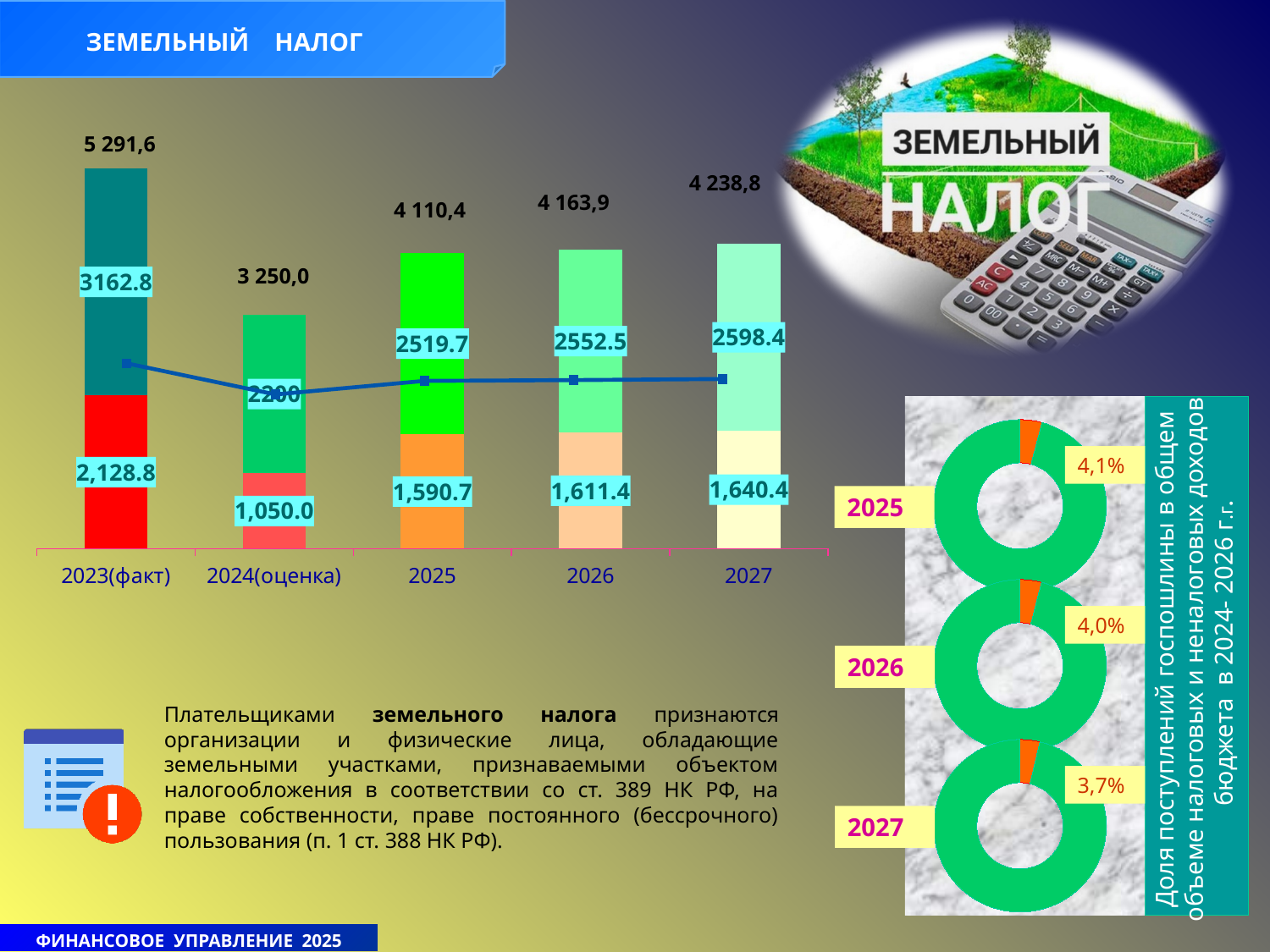
In the donut charts on the right, which year has the lowest percentage? 2027 In the stacked bar chart, what is the difference between the bottom segment values of the 2027 bar and the 2026 bar? 29.0 In the stacked bar chart, which category has the highest total value? 2023(факт) In the stacked bar chart, do the total values rise or fall from 2025 to 2027? rise In the stacked bar chart, which category has the lowest total value? 2024(оценка) In the donut charts on the right, what percentage is shown for 2025? 4,1% In the stacked bar chart, what is the value of the top segment of the 2027 bar? 2598.4 In the stacked bar chart, what is the total value labelled above the bar for 2023(факт)? 5 291,6 In the stacked bar chart, how many categories are shown on the x axis? 5 In the stacked bar chart, what is the value of the bottom segment of the 2025 bar? 1,590.7 In the stacked bar chart, is the bottom segment of the 2026 bar larger or smaller than the bottom segment of the 2023(факт) bar? smaller In the stacked bar chart, what is the total value labelled above the bar for 2024(оценка)? 3 250,0